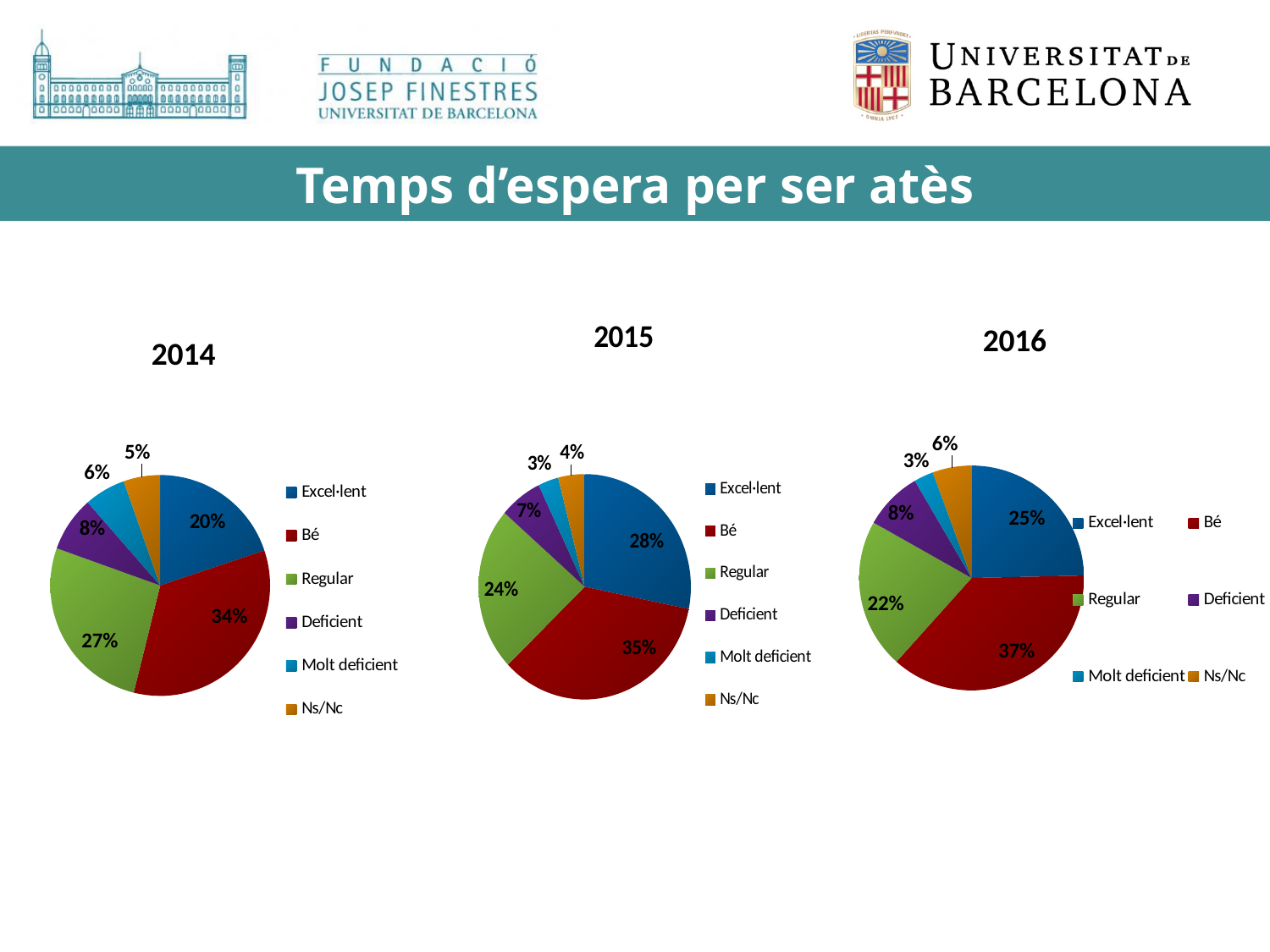
In the 2014 chart, what share does Bé have? 34% In the 2015 chart, which category has the smallest slice? Molt deficient What is the title of the slide containing the three charts? Temps d'espera per ser atès What kind of chart is the 2015 chart? Pie chart In the 2016 chart, which category has the largest slice? Bé In the 2014 chart, which category has the largest slice? Bé In the 2015 chart, what share does Regular have? 24% In the 2015 chart, which is larger, Excel·lent or Regular? Excel·lent In the 2016 chart, what is the difference between the Bé and Regular shares? 15% How many categories does the 2014 chart's legend list? 6 In the 2014 chart, what share does Ns/Nc have? 5% In the 2016 chart, what share does Excel·lent have? 25%